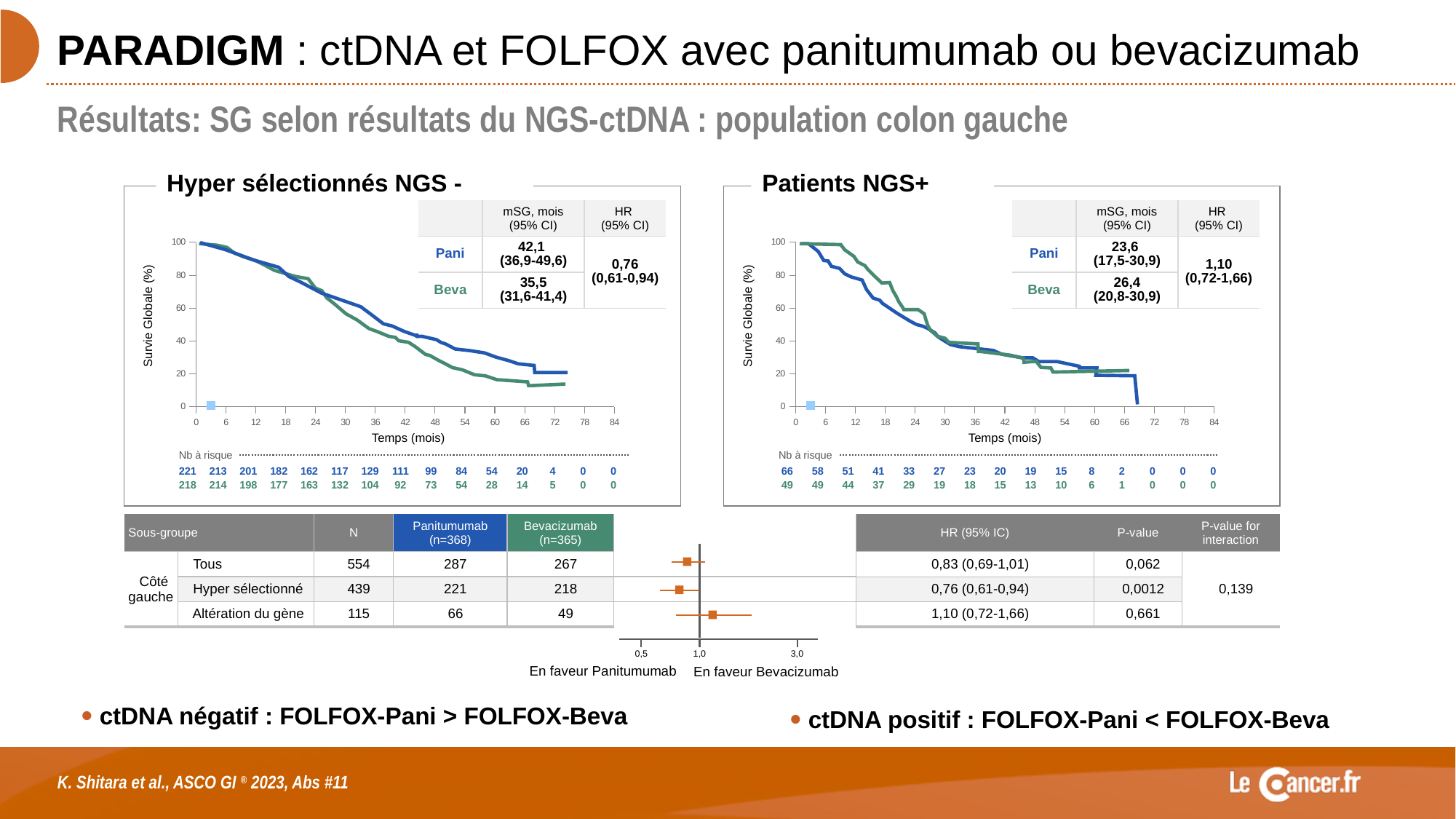
In the 'Patients NGS+' chart, what is the median overall survival (mSG) in months for Beva? 26,4 In the 'Hyper sélectionnés NGS -' chart, what is the difference in median overall survival (months) between Pani and Beva? 6,6 In the 'Patients NGS+' chart, which arm has the higher median overall survival, Pani or Beva? Beva What kind of chart are the two survival plots at the top of the slide? Line chart (Kaplan-Meier survival curves) In the 'Hyper sélectionnés NGS -' chart, what is the median overall survival (mSG) in months for Pani? 42,1 In the 'Hyper sélectionnés NGS -' chart, what is the median overall survival (mSG) in months for Beva? 35,5 In the 'Patients NGS+' chart, how many patients are at risk at time 0 in the Beva arm? 49 In the 'Patients NGS+' chart, what is the hazard ratio (HR) with its 95% CI? 1,10 (0,72-1,66) In the 'Hyper sélectionnés NGS -' chart, do the survival curves rise or fall as time increases? Fall In the 'Hyper sélectionnés NGS -' chart, what is the hazard ratio (HR) shown? 0,76 In the 'Hyper sélectionnés NGS -' chart, how many patients are at risk at time 0 in the Pani arm? 221 In the forest plot at the bottom, what is the P-value for the 'Hyper sélectionné' subgroup? 0,0012